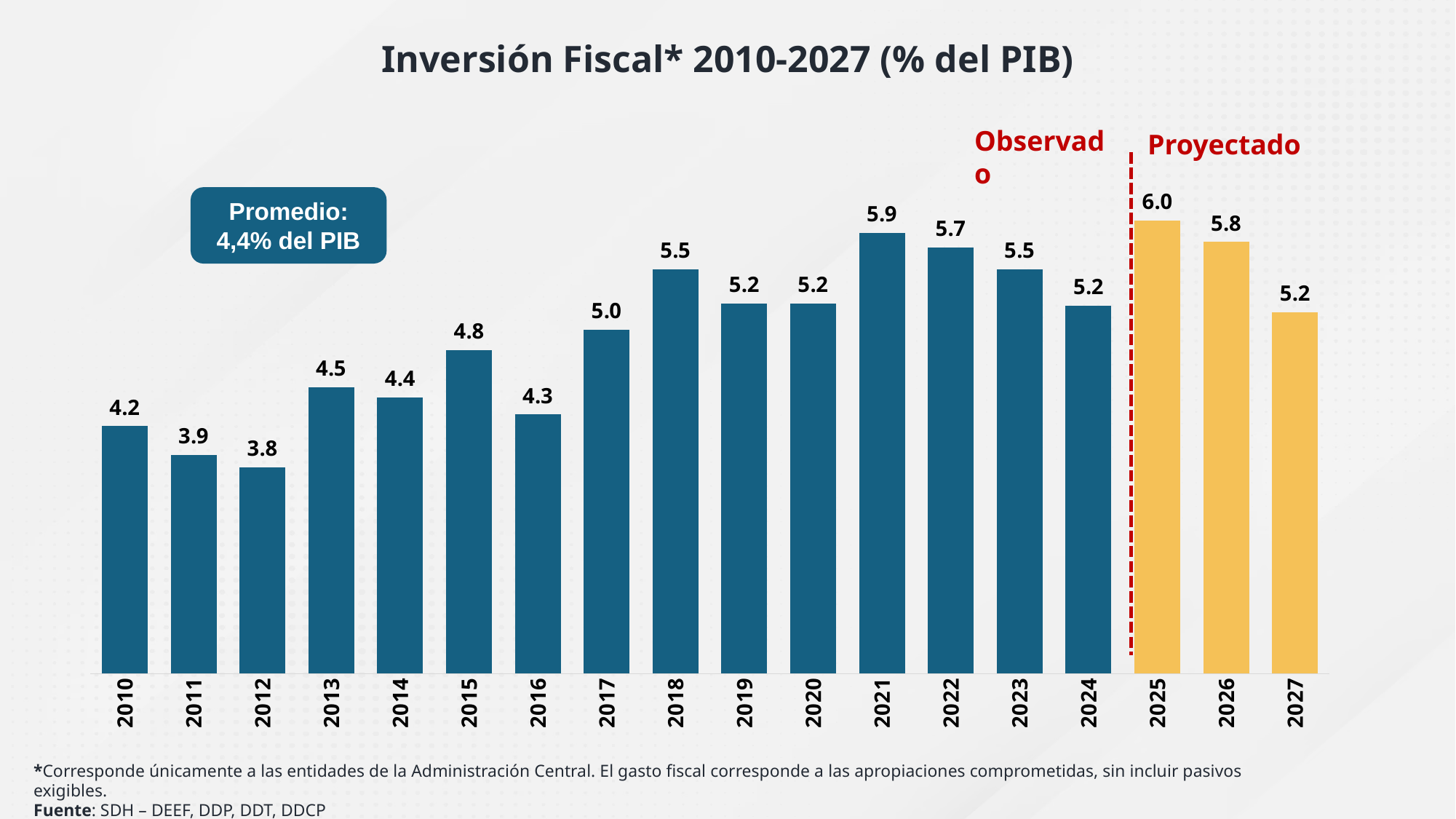
Which year has the highest value? 2025 What is the value for 2012? 3.8 What is the value for 2025? 6.0 Which is larger, the value for 2015 or the value for 2016? 2015 What kind of chart is this? Bar chart What average (Promedio) is stated in the box on the chart? 4,4% del PIB What is the difference between the values for 2021 and 2010? 1.7 Do the values rise or fall from 2012 to 2015? Rise What is the title of the chart? Inversión Fiscal* 2010-2027 (% del PIB) Which year has the lowest value? 2012 What is the value for 2018? 5.5 How many years are shown on the x axis? 18